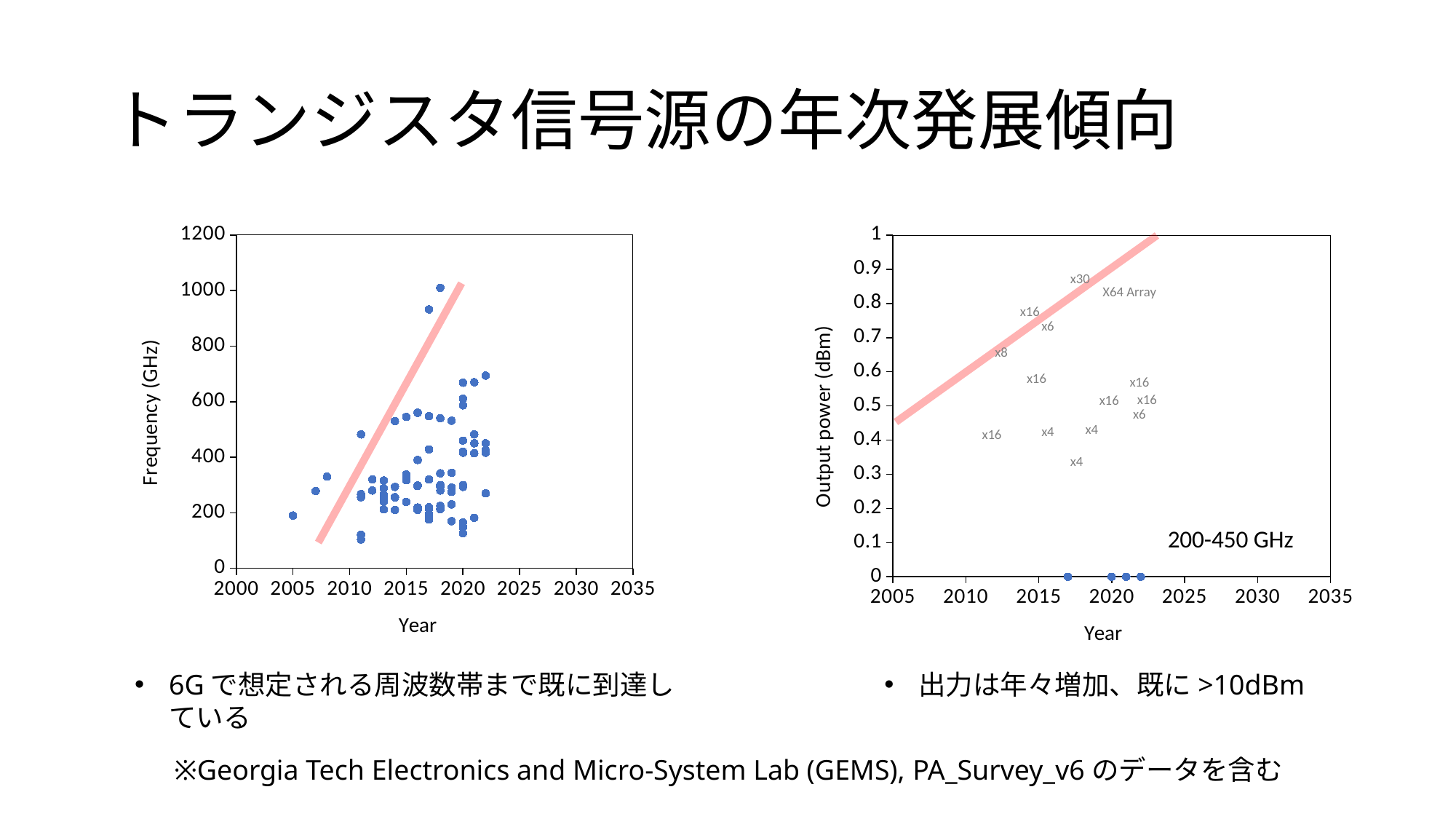
On the left chart, is the frequency value plotted at 2007 greater or less than 200? greater On the left chart, does the pink trend line rise or fall as the year increases? rise On the left chart, is the lowest frequency value plotted around 2011 greater or less than 200? less On the left chart, is the frequency value plotted at 2005 greater or less than 400? less What is the maximum value shown on the y axis of the left chart? 1200 What kind of chart is the left chart (Frequency vs Year)? scatter chart On the right chart, does the pink trend line rise or fall as the year increases? rise What kind of chart is the right chart (Output power vs Year)? scatter chart What is the maximum value shown on the x axis of the right chart? 2035 On the left chart, what is the label of the y axis? Frequency (GHz)